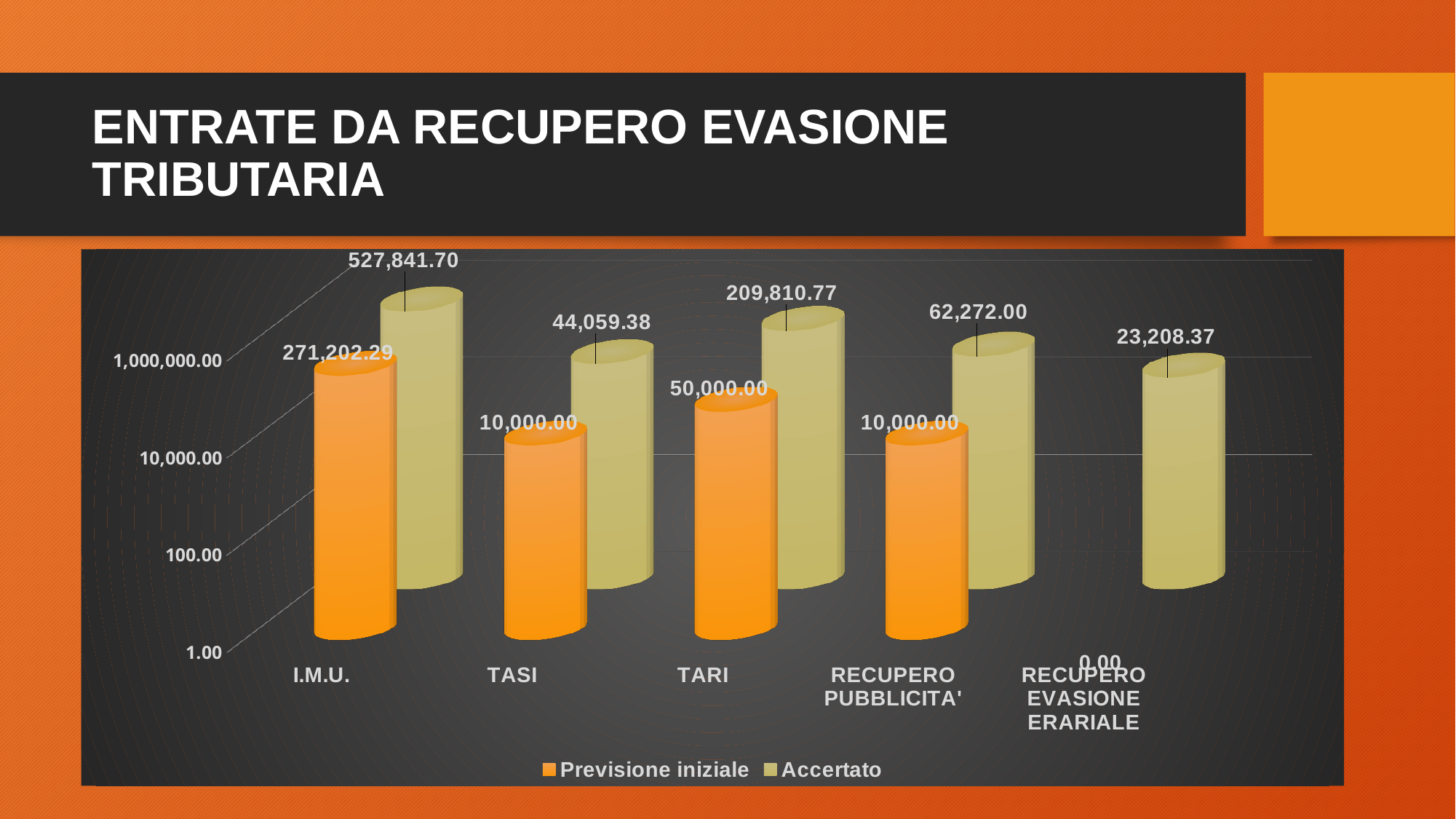
What kind of chart is shown on the slide? Bar chart How many categories are shown on the x axis? 5 Which category has the highest Accertato value? I.M.U. What is the Previsione iniziale value for TARI? 50,000.00 Which is larger for TASI: the Previsione iniziale or the Accertato value? Accertato What is the Previsione iniziale value for RECUPERO PUBBLICITA'? 10,000.00 How many series does the legend list? 2 What is the Accertato value for RECUPERO EVASIONE ERARIALE? 23,208.37 Which category has the lowest Accertato value? RECUPERO EVASIONE ERARIALE What is the Accertato value for I.M.U.? 527,841.70 What is the difference between the Accertato and Previsione iniziale values for I.M.U.? 256,639.41 What is the difference between the Accertato and Previsione iniziale values for TARI? 159,810.77